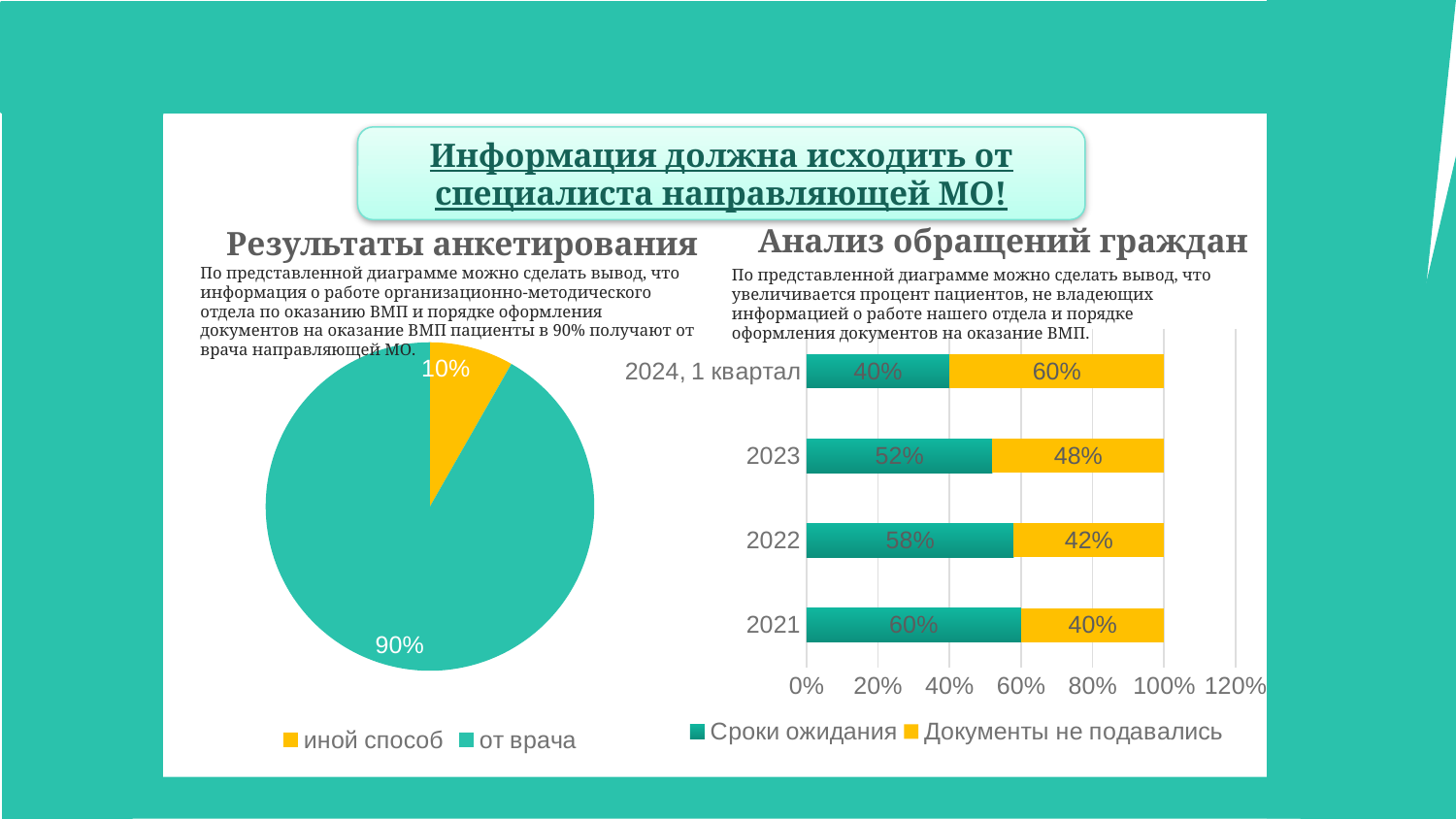
In the bar chart on the right, which is larger for 2022: "Сроки ожидания" or "Документы не подавались"? Сроки ожидания In the pie chart on the left, what share does the slice "от врача" have? 90% In the bar chart on the right, how do the "Сроки ожидания" values change from 2021 to 2024, 1 квартал? They fall How many categories does the bar chart on the right show? 4 In the pie chart on the left, what is the value for "иной способ"? 10% What kind of chart is the chart on the left of the slide? Pie chart How many entries does the legend of the pie chart on the left list? 2 In the bar chart on the right, which category has the highest value for "Сроки ожидания"? 2021 In the bar chart on the right, what is the value of "Документы не подавались" for 2024, 1 квартал? 60% In the bar chart on the right, what is the difference between the "Сроки ожидания" values for 2021 and 2024, 1 квартал? 20% In the bar chart on the right, which category has the lowest value for "Документы не подавались"? 2021 In the bar chart on the right, what is the value of "Сроки ожидания" for 2023? 52%